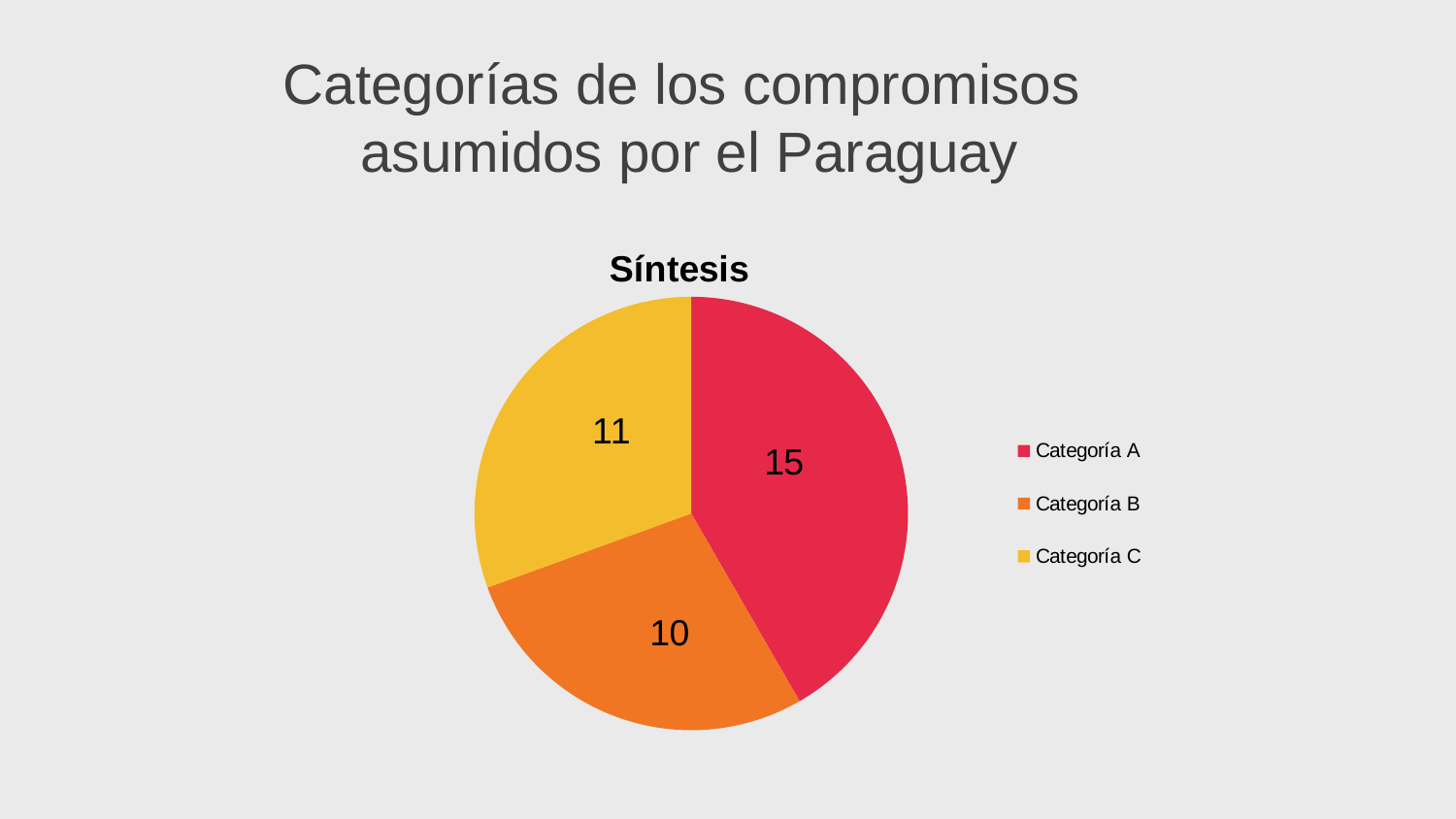
What is the value for Categoría A? 15 Which category has the smallest slice? Categoría B What is the difference between the values for Categoría A and Categoría B? 5 What share of the total does Categoría A represent? 15 of 36 What is the difference between the values for Categoría C and Categoría B? 1 Which category has the largest slice? Categoría A What is the value for Categoría C? 11 What is the title of the chart? Síntesis What is the value for Categoría B? 10 Which is larger, the value for Categoría A or Categoría C? Categoría A What kind of chart is shown on the slide? Pie chart How many slices does the pie chart have? 3